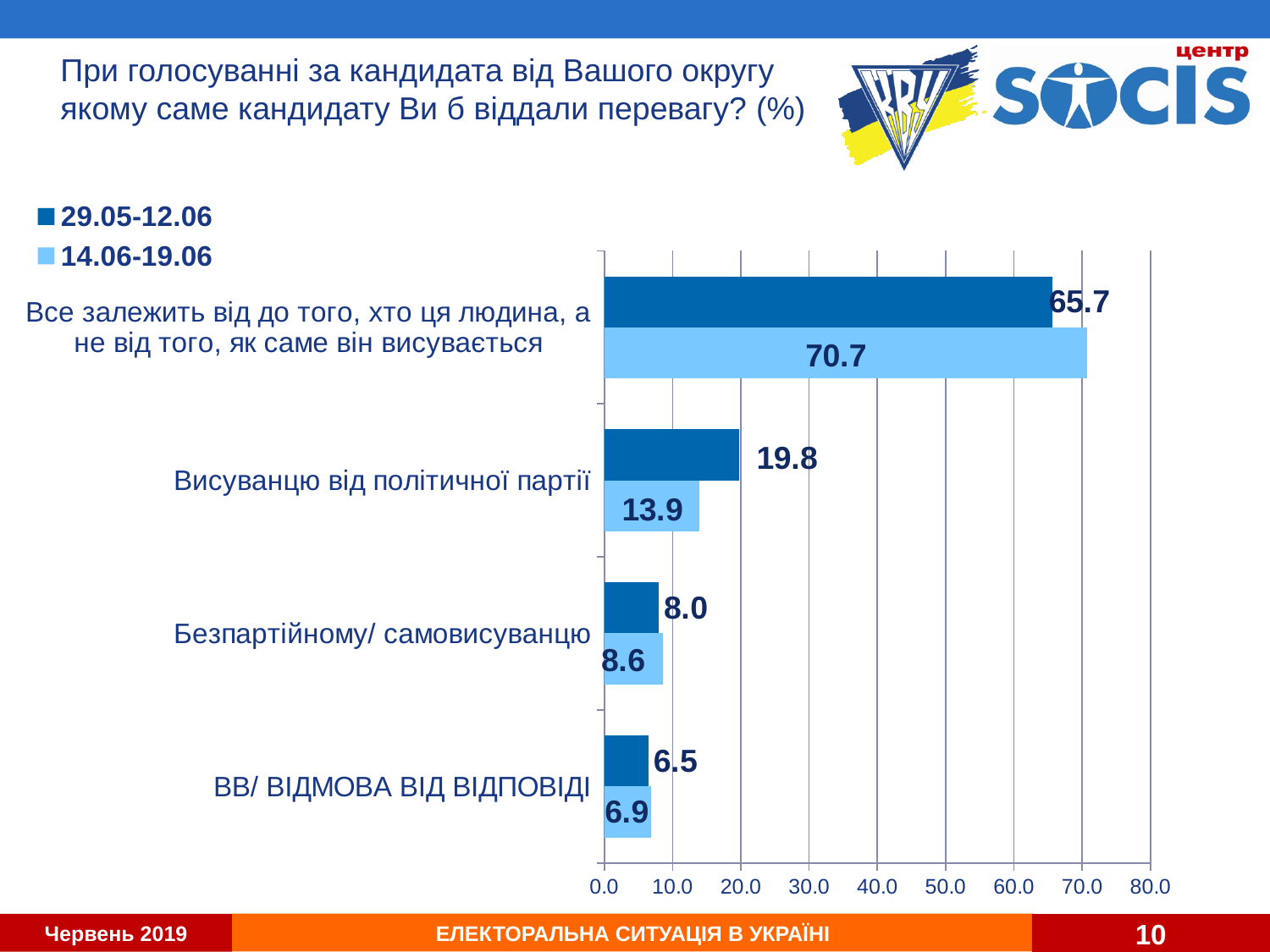
What is the value for "Безпартійному/ самовисуванцю" in the 14.06-19.06 series? 8.6 Which category has the highest value in the 14.06-19.06 series? Все залежить від до того, хто ця людина, а не від того, як саме він висувається What is the value for "ВВ/ ВІДМОВА ВІД ВІДПОВІДІ" in the 29.05-12.06 series? 6.5 What is the value for "Все залежить від до того, хто ця людина, а не від того, як саме він висувається" in the 14.06-19.06 series? 70.7 What is the value for "Висуванцю від політичної партії" in the 29.05-12.06 series? 19.8 For "Висуванцю від політичної партії", which series has the larger value: 29.05-12.06 or 14.06-19.06? 29.05-12.06 What is the difference between the 14.06-19.06 and 29.05-12.06 values for "Все залежить від до того, хто ця людина, а не від того, як саме він висувається"? 5.0 Is the 29.05-12.06 value for "Все залежить від до того, хто ця людина, а не від того, як саме він висувається" greater or less than 60.0? greater How many series does the legend list? 2 How many categories are shown on the chart? 4 What kind of chart is shown on the slide? bar chart Which category has the lowest value in the 29.05-12.06 series? ВВ/ ВІДМОВА ВІД ВІДПОВІДІ